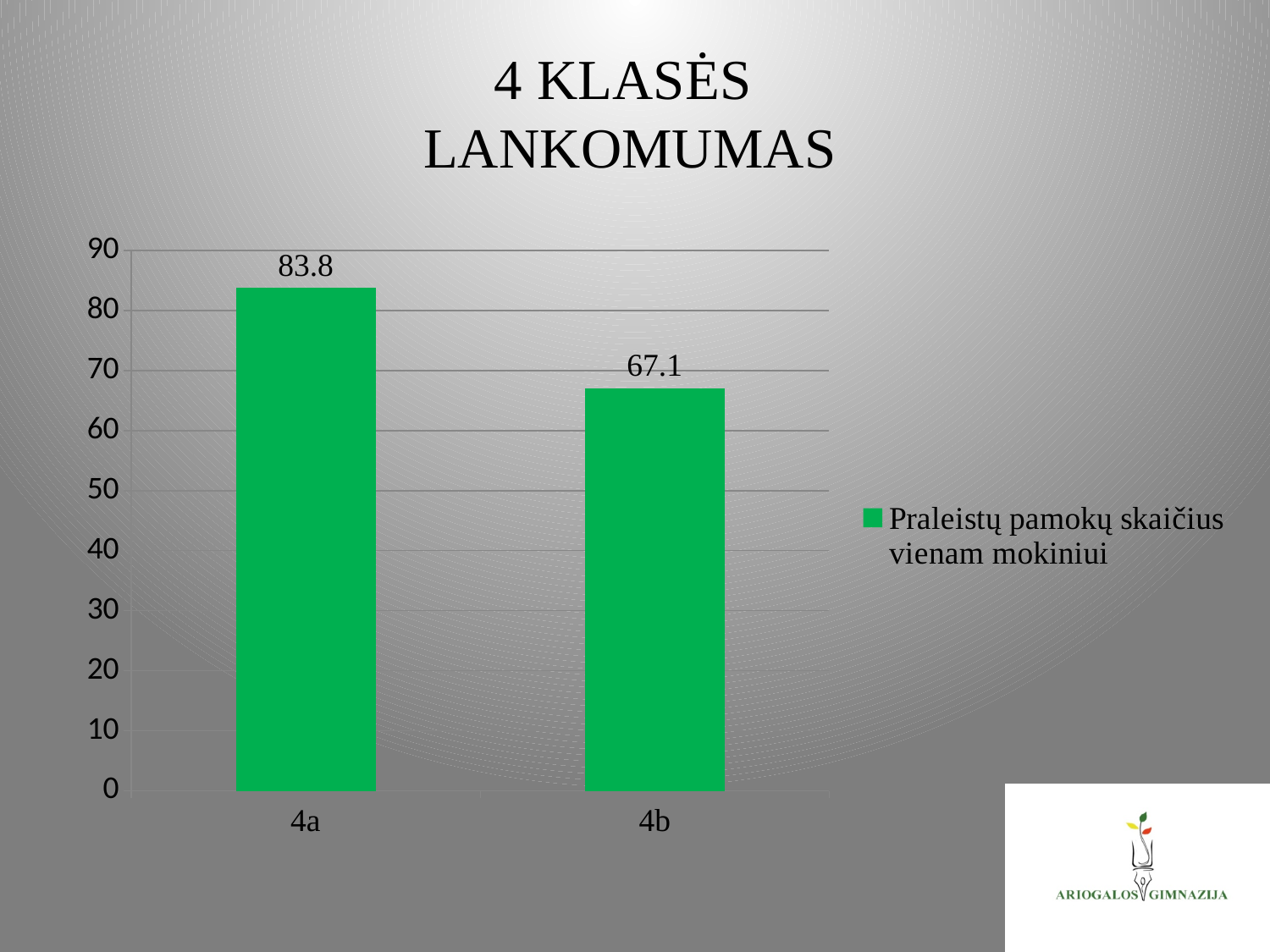
Which class has the highest value? 4a What is the difference between the values for 4a and 4b? 16.7 How many classes are shown on the chart? 2 Which class has the lowest value? 4b Is the value for 4a greater or less than 80? greater How many series does the legend list? 1 Is the value for 4b greater or less than 70? less What kind of chart is shown on the slide? bar chart What is the value for class 4a? 83.8 What is the value for class 4b? 67.1 Which is larger, the value for 4a or the value for 4b? 4a What is the legend entry of the series shown on the chart? Praleistų pamokų skaičius vienam mokiniui